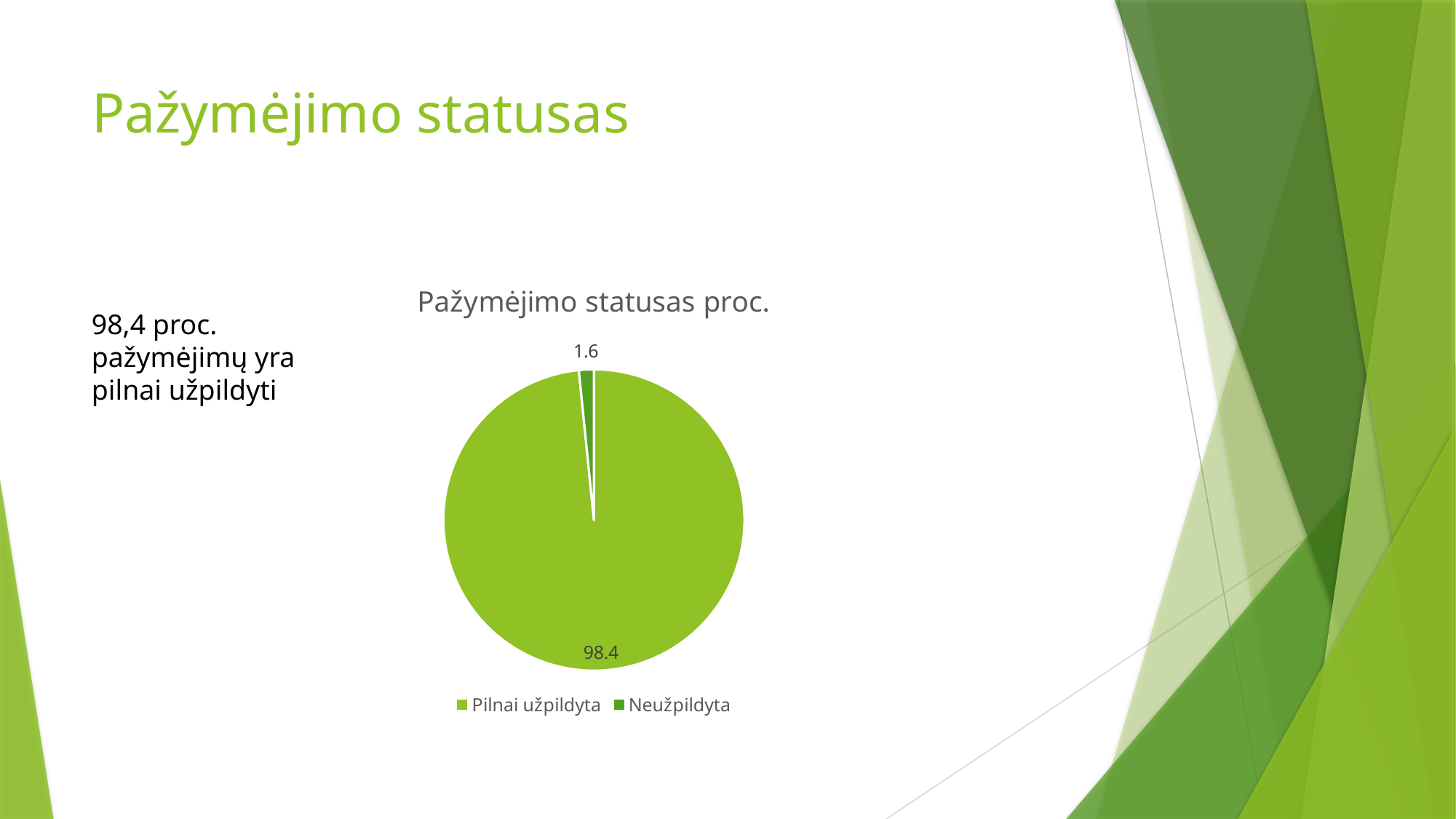
How many slices does the pie chart have? 2 What share of the pie does Neužpildyta represent? 1.6 What is the title of the chart? Pažymėjimo statusas proc. What is the total of the two slice values? 100 What is the value for Neužpildyta? 1.6 Which category has the smallest slice? Neužpildyta What is the difference between the values for Pilnai užpildyta and Neužpildyta? 96.8 Which category has the largest slice? Pilnai užpildyta How many entries does the legend list? 2 What is the value for Pilnai užpildyta? 98.4 Which is larger, the value for Pilnai užpildyta or Neužpildyta? Pilnai užpildyta What kind of chart is shown on the slide? pie chart